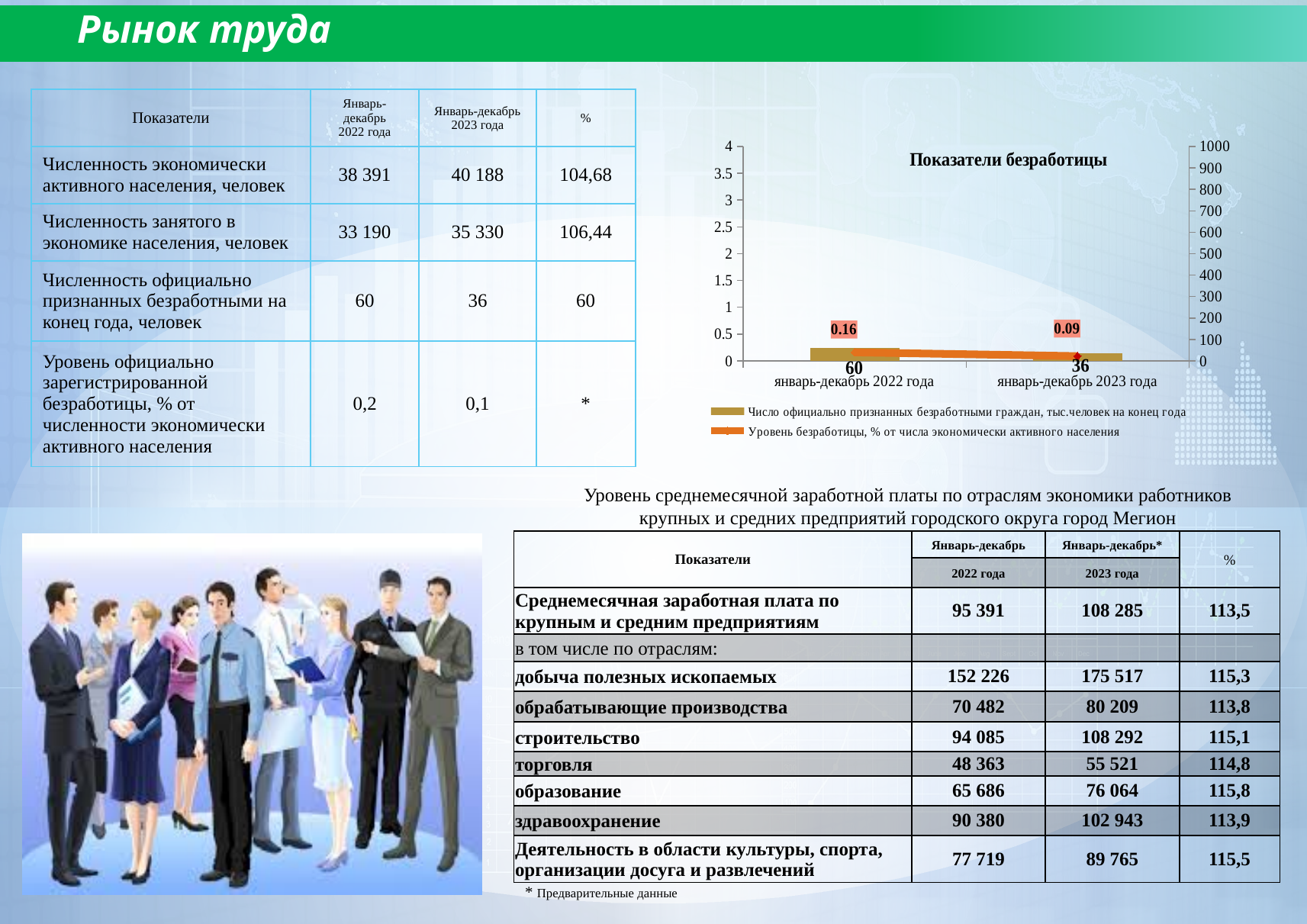
In the chart "Показатели безработицы", which period has the lower unemployment rate? январь-декабрь 2023 года In the chart "Показатели безработицы", does the unemployment rate rise or fall from январь-декабрь 2022 года to январь-декабрь 2023 года? fall In the chart "Показатели безработицы", how many periods are shown on the x axis? 2 In the chart "Показатели безработицы", how many series does the legend list? 2 In the chart "Показатели безработицы", what is the difference between the bar values for январь-декабрь 2022 года and январь-декабрь 2023 года? 24 In the chart "Показатели безработицы", what is the unemployment rate (Уровень безработицы) value shown for январь-декабрь 2022 года? 0.16 In the chart "Показатели безработицы", what is the unemployment rate (Уровень безработицы) value shown for январь-декабрь 2023 года? 0.09 What is the title of the chart on the slide? Показатели безработицы In the chart "Показатели безработицы", what is the value of the bar for январь-декабрь 2023 года? 36 In the chart "Показатели безработицы", which series is drawn as bars? Число официально признанных безработными граждан, тыс.человек на конец года In the chart "Показатели безработицы", which period has the higher number of officially recognized unemployed citizens? январь-декабрь 2022 года In the chart "Показатели безработицы", what is the value of the bar for январь-декабрь 2022 года? 60